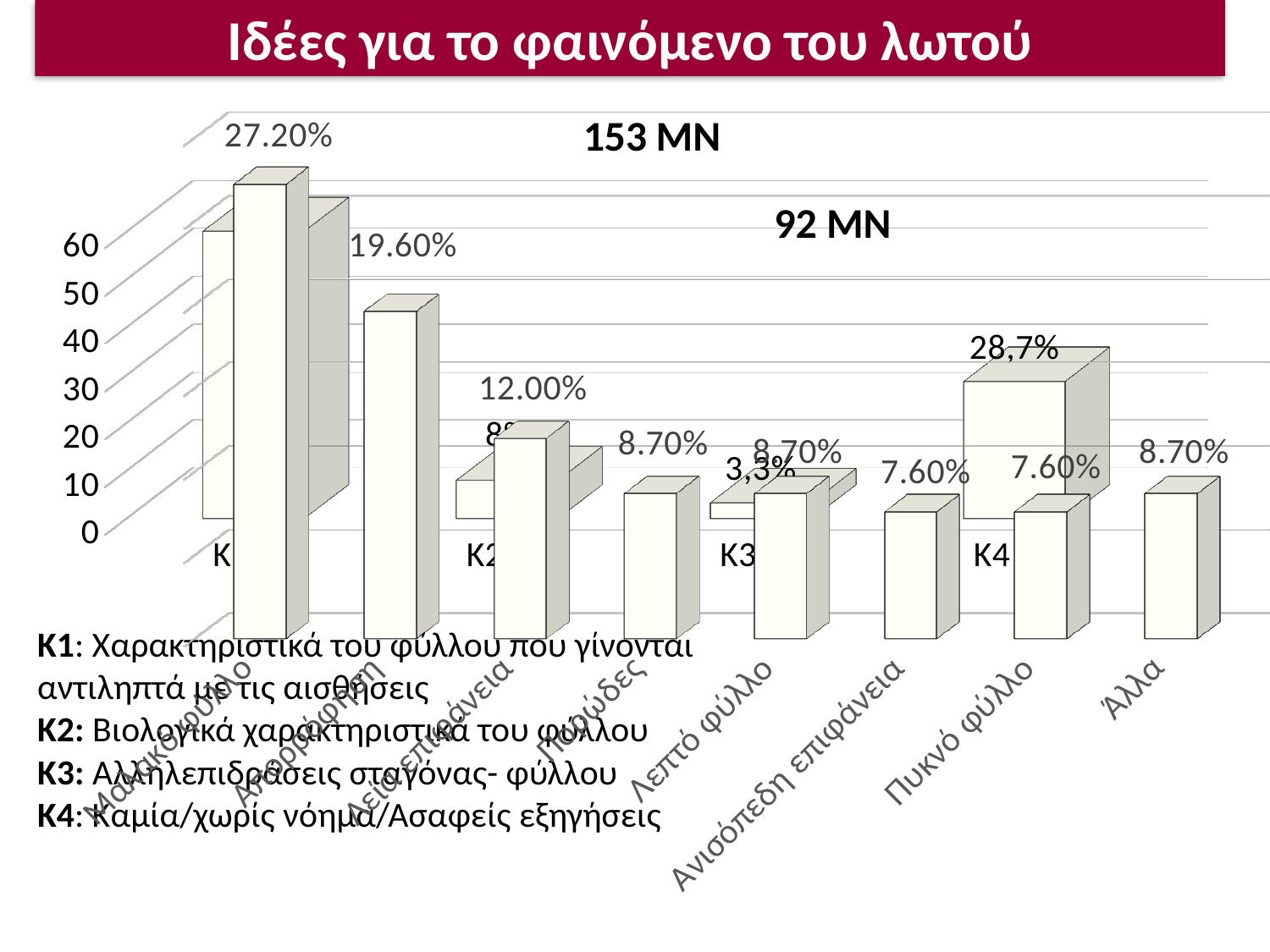
What is the value labelled for Ανισόπεδη επιφάνεια in the front series? 7.60% Which category has the highest value in the front series? Μαλακό φύλλο What is the value labelled for Μαλακό φύλλο in the front series? 27.20% Which has the larger front-series value, Απορρόφηση or Λεία επιφάνεια? Απορρόφηση What is the value labelled for Απορρόφηση in the front series? 19.60% What is the value labelled for Άλλα in the front series? 8.70% What is the value labelled for Λεία επιφάνεια in the front series? 12.00% What is the highest tick value shown on the vertical axis? 60 What kind of chart is shown on the slide? bar chart What is the difference between the front-series values for Μαλακό φύλλο and Απορρόφηση? 7.60%